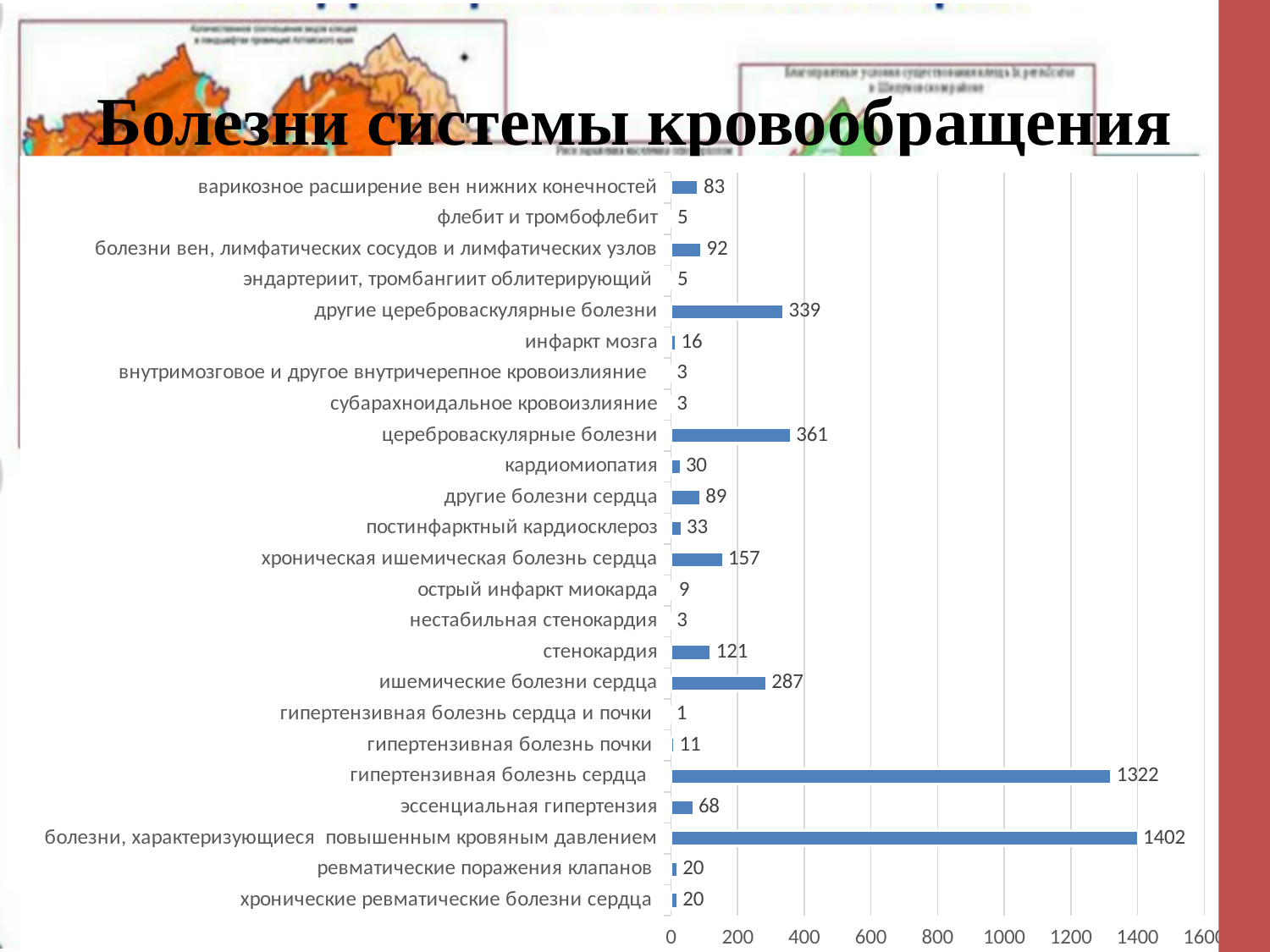
What is the value for гипертензивная болезнь сердца? 1322 Which is larger: the value for хроническая ишемическая болезнь сердца or the value for стенокардия? хроническая ишемическая болезнь сердца What is the value for стенокардия? 121 Which category has the highest value? болезни, характеризующиеся повышенным кровяным давлением What is the difference between the values for болезни, характеризующиеся повышенным кровяным давлением and гипертензивная болезнь сердца? 80 What is the difference between the values for цереброваскулярные болезни and другие цереброваскулярные болезни? 22 What type of chart is shown on the slide? bar chart Which category has the lowest value? гипертензивная болезнь сердца и почки How many categories are shown in the chart? 24 Is the value for ишемические болезни сердца greater or less than 200? greater What is the value for эссенциальная гипертензия? 68 What is the value for другие цереброваскулярные болезни? 339